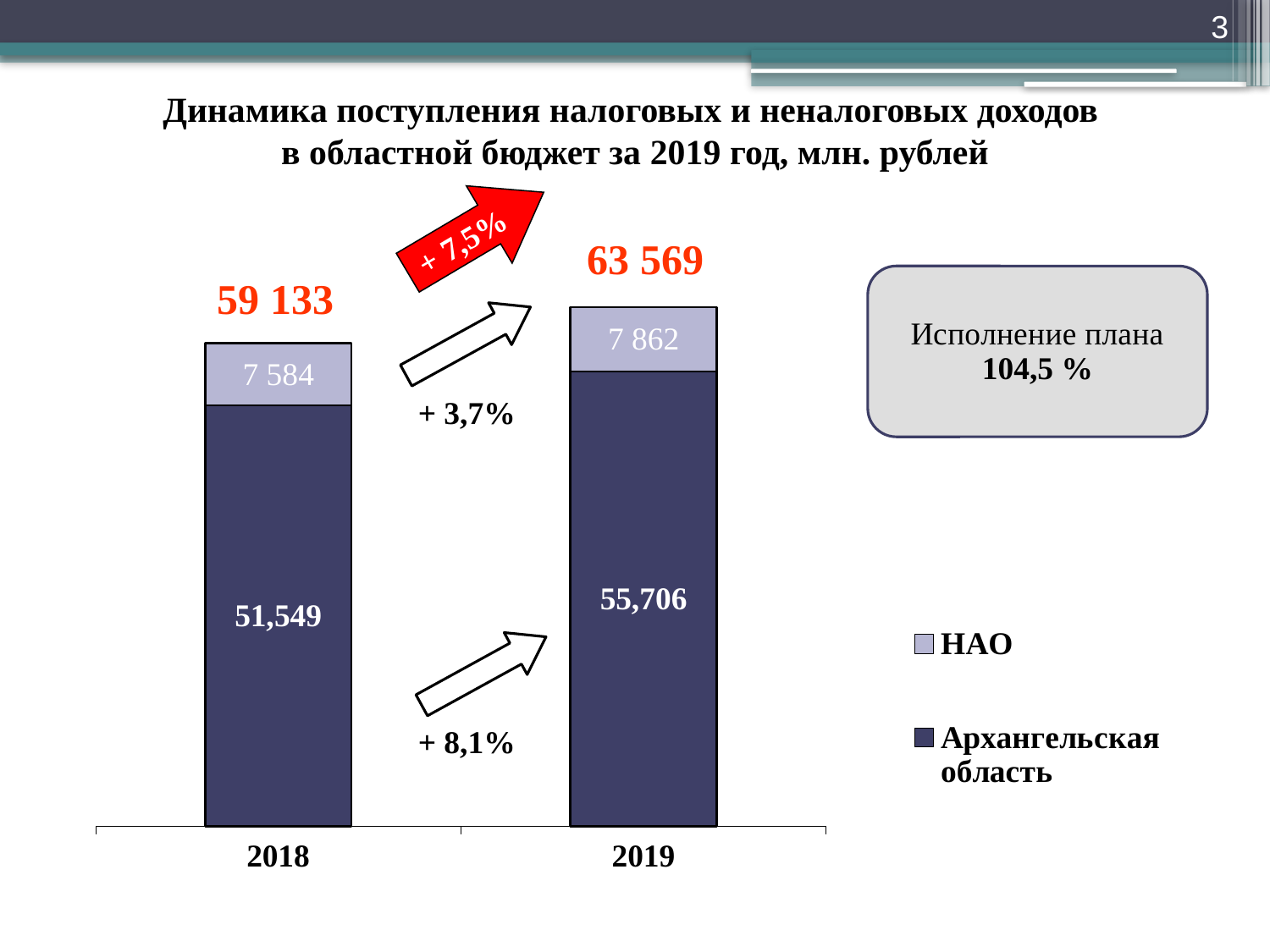
What kind of chart is shown on the slide? stacked bar chart What is the total of the stacked bar for 2019? 63 569 What is the value for НАО in 2019? 7 862 How many categories are shown on the x axis? 2 What is the value for Архангельская область in 2019? 55,706 What is the total of the stacked bar for 2018? 59 133 Which year has the higher total? 2019 What is the value for НАО in 2018? 7 584 By what percentage did the total grow from 2018 to 2019, according to the red arrow? + 7,5% How many series does the legend list? 2 What is the value for Архангельская область in 2018? 51,549 Which is larger in 2019: the value for НАО or the value for Архангельская область? Архангельская область